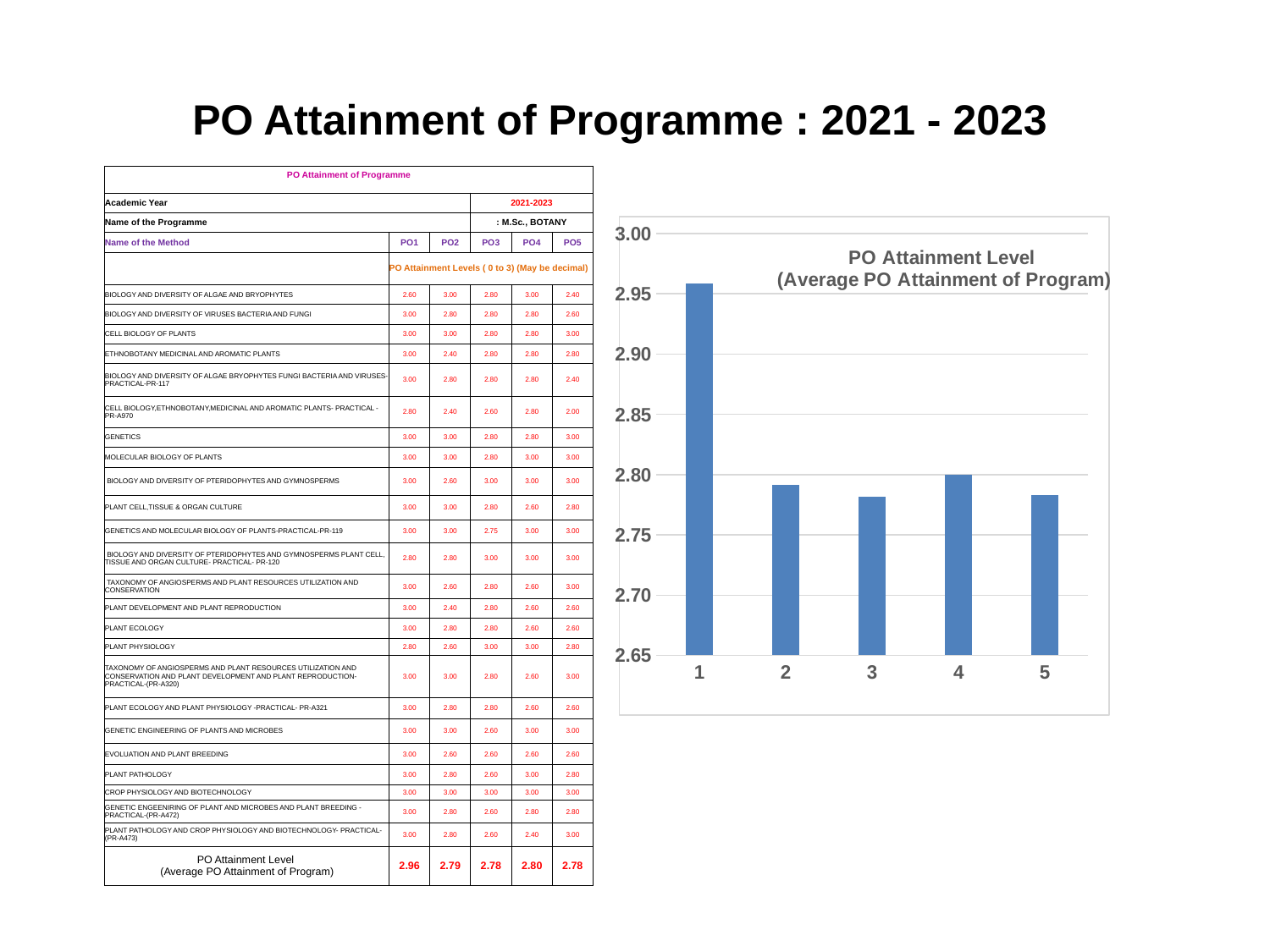
What colour are the bars in the chart? blue Is the value for category 1 greater or less than 2.90? greater Which category has the highest bar in the chart? 1 How many bars are plotted in the chart? 5 What is the title of the chart? PO Attainment Level (Average PO Attainment of Program) Which is larger, the value for category 1 or the value for category 2? category 1 Is the value for category 2 greater or less than 2.80? less Is the value for category 5 greater or less than 2.80? less What kind of chart is shown on the slide? bar chart What is the value for category 4 in the chart? 2.80